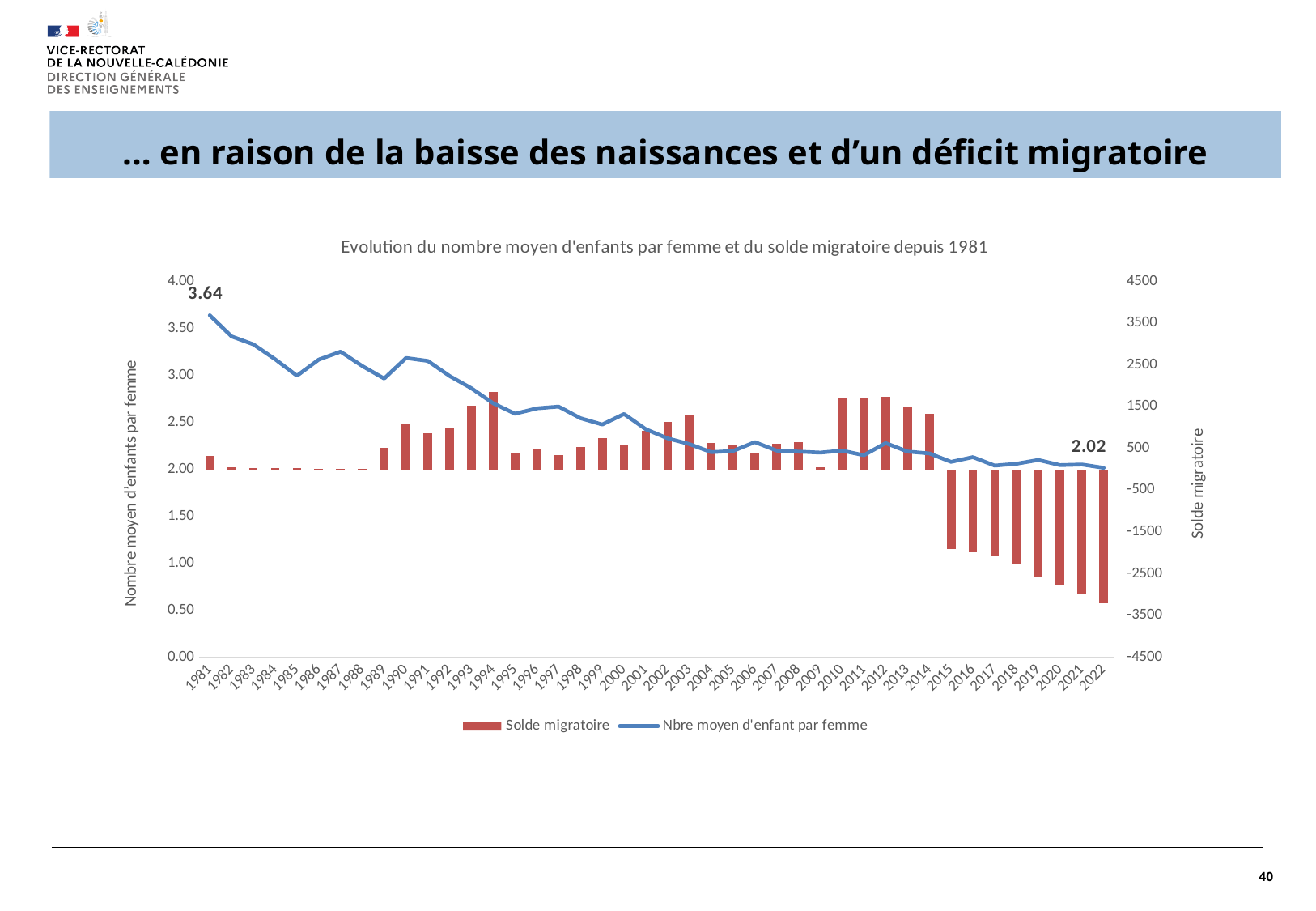
Is the 'Solde migratoire' value for 2022 greater or less than -2500? less How many series does the legend list? 2 Does the 'Nbre moyen d'enfant par femme' line generally rise or fall from 1981 to 2022? fall Is the 'Solde migratoire' value for 1994 greater or less than 1000? greater What is the title of the chart? Evolution du nombre moyen d'enfants par femme et du solde migratoire depuis 1981 What kind of chart is this? Combined bar and line chart How many years are shown on the x axis? 42 Which year has the lowest (most negative) 'Solde migratoire'? 2022 What is the value of 'Nbre moyen d'enfant par femme' in 2022? 2.02 By how much did the average number of children per woman fall between 1981 and 2022? 1.62 What is the value of 'Nbre moyen d'enfant par femme' in 1981? 3.64 Which is larger, the average number of children per woman in 1981 or in 2022? 1981